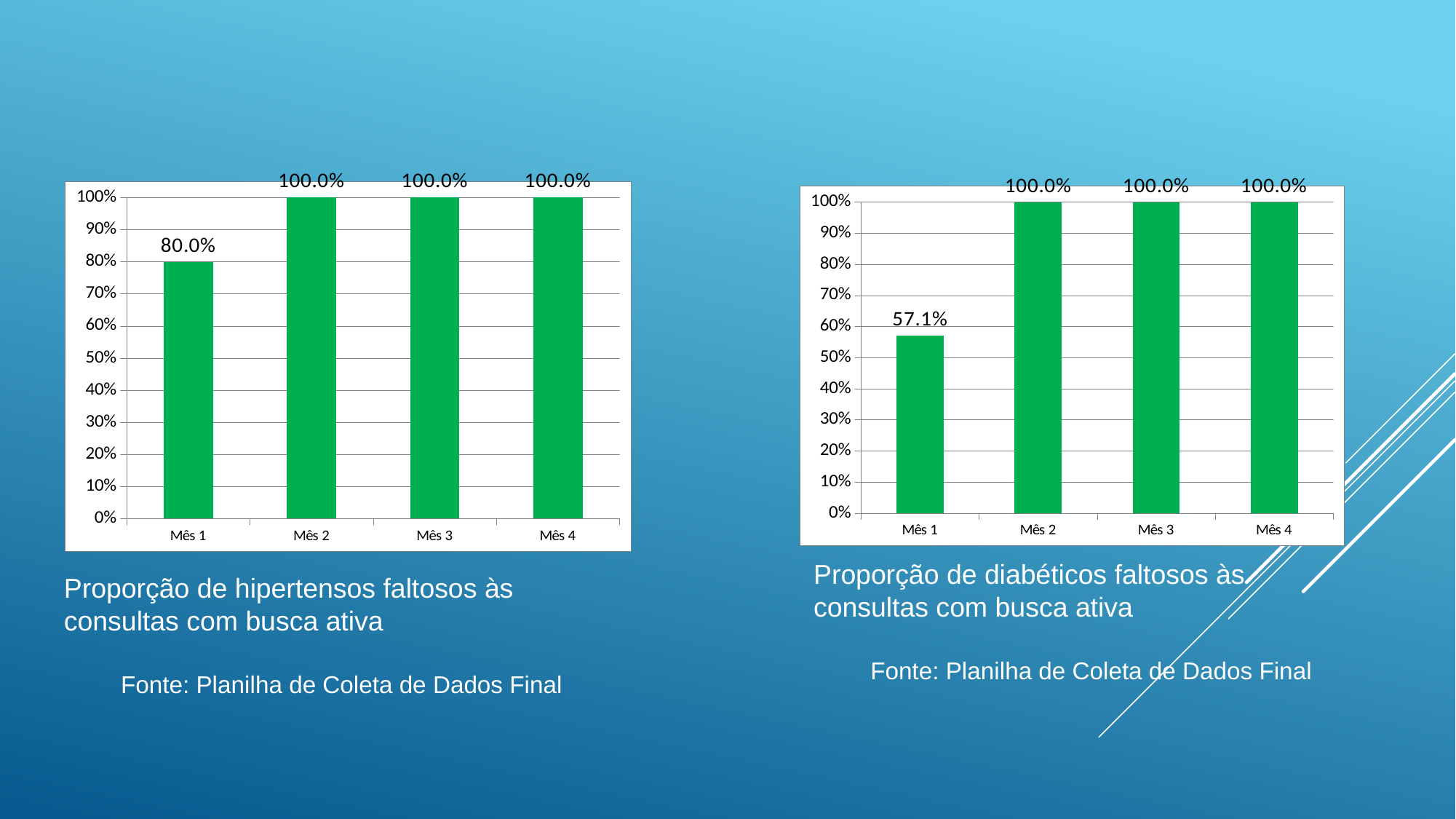
In the right chart (diabéticos), which month has the lowest value? Mês 1 What kind of chart is the left chart (hipertensos)? Bar chart In the left chart (hipertensos), what is the value for Mês 3? 100.0% In the right chart (diabéticos), do the values rise or fall from Mês 1 to Mês 2? Rise In the right chart (diabéticos), what is the difference between the values for Mês 2 and Mês 1? 42.9% How many months are shown on the x axis of the right chart (diabéticos)? 4 In the left chart (Proporção de hipertensos faltosos às consultas com busca ativa), what is the value for Mês 1? 80.0% In the right chart (Proporção de diabéticos faltosos às consultas com busca ativa), what is the value for Mês 1? 57.1% Which is larger: the Mês 1 value in the left chart (hipertensos) or the Mês 1 value in the right chart (diabéticos)? Left chart (hipertensos), 80.0% In the left chart (hipertensos), which month has the lowest value? Mês 1 In the right chart (diabéticos), what is the value for Mês 4? 100.0% In the left chart (hipertensos), what is the difference between the values for Mês 2 and Mês 1? 20.0%